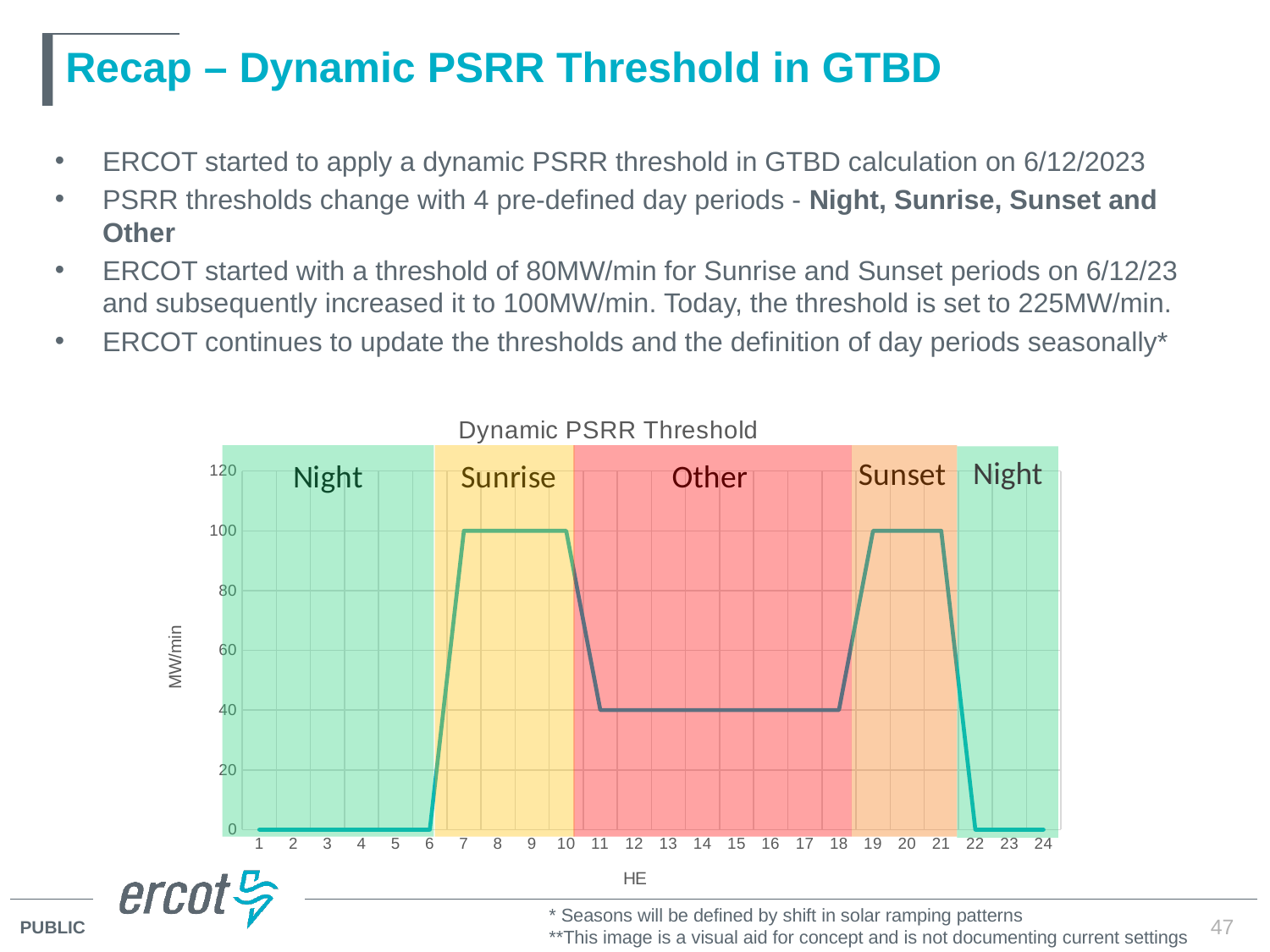
What is the y-axis label of the chart? MW/min Does the line rise or fall between HE 10 and HE 11? fall What is the value of the line at HE 20? 100 What is the value of the line at HE 14? 40 What is the difference between the value at HE 9 and the value at HE 15? 60 What is the value of the line at HE 3? 0 What is the title of the chart? Dynamic PSRR Threshold What kind of chart is shown on the slide? line chart Is the value at HE 16 greater or less than 60? less How many hour-ending (HE) points are shown on the x axis? 24 What is the value of the line at HE 8? 100 Which is larger, the value at HE 12 or the value at HE 19? HE 19